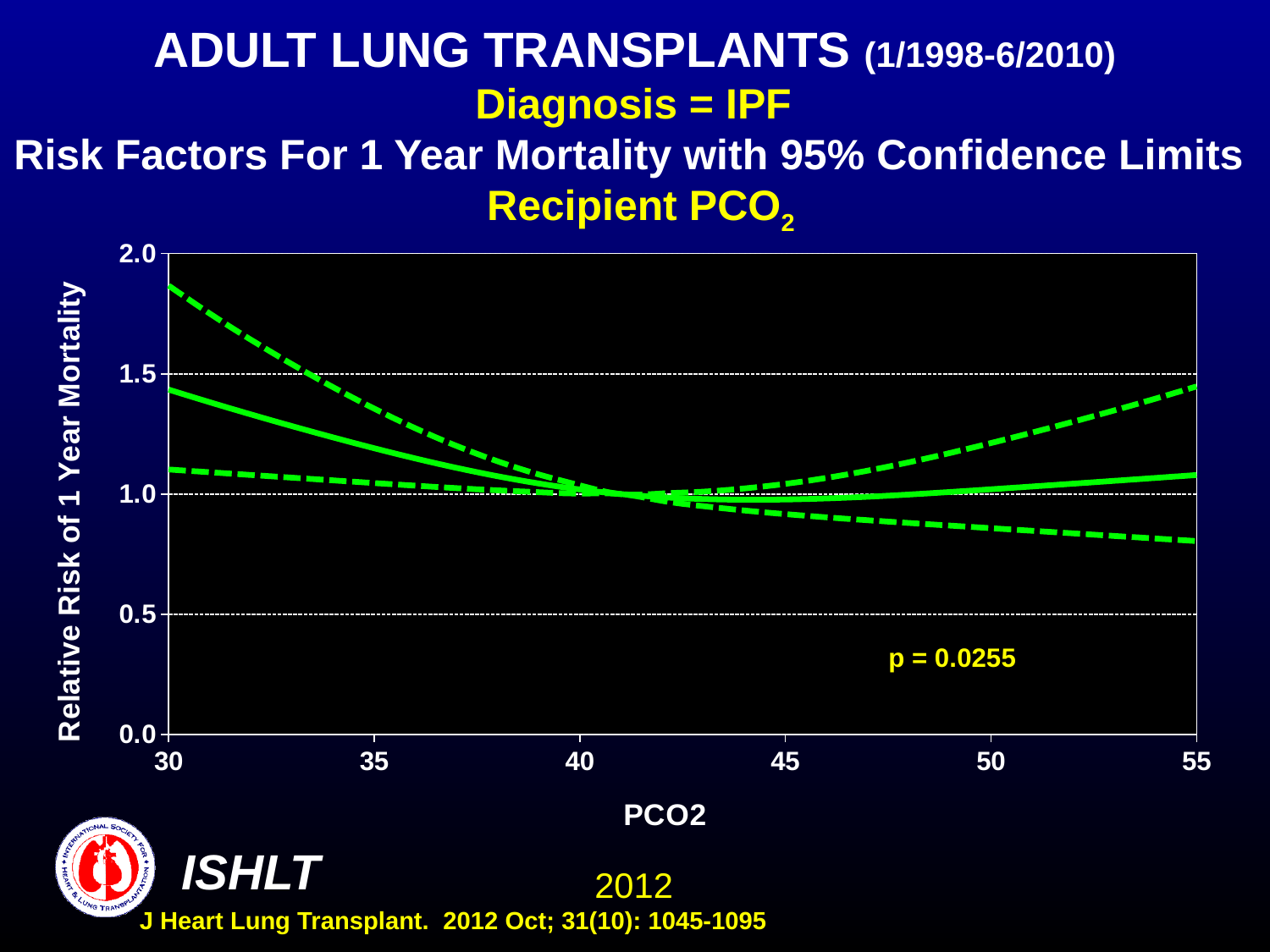
Is the value of the lower dashed confidence limit at PCO2 = 55 greater or less than 1.0? less Does the upper dashed confidence limit rise or fall as PCO2 increases from 45 to 55? rise How many lines are plotted on the chart? 3 Is the value of the lower dashed confidence limit at PCO2 = 55 greater or less than 0.5? greater What is the p-value printed on the chart? p = 0.0255 Is the value of the upper dashed confidence limit at PCO2 = 55 greater or less than 1.0? greater Does the solid relative-risk line rise or fall as PCO2 increases from 30 to 40? fall Is the solid relative-risk line higher at PCO2 = 30 or at PCO2 = 55? 30 What is the label of the y axis? Relative Risk of 1 Year Mortality What kind of chart is shown on the slide? line chart